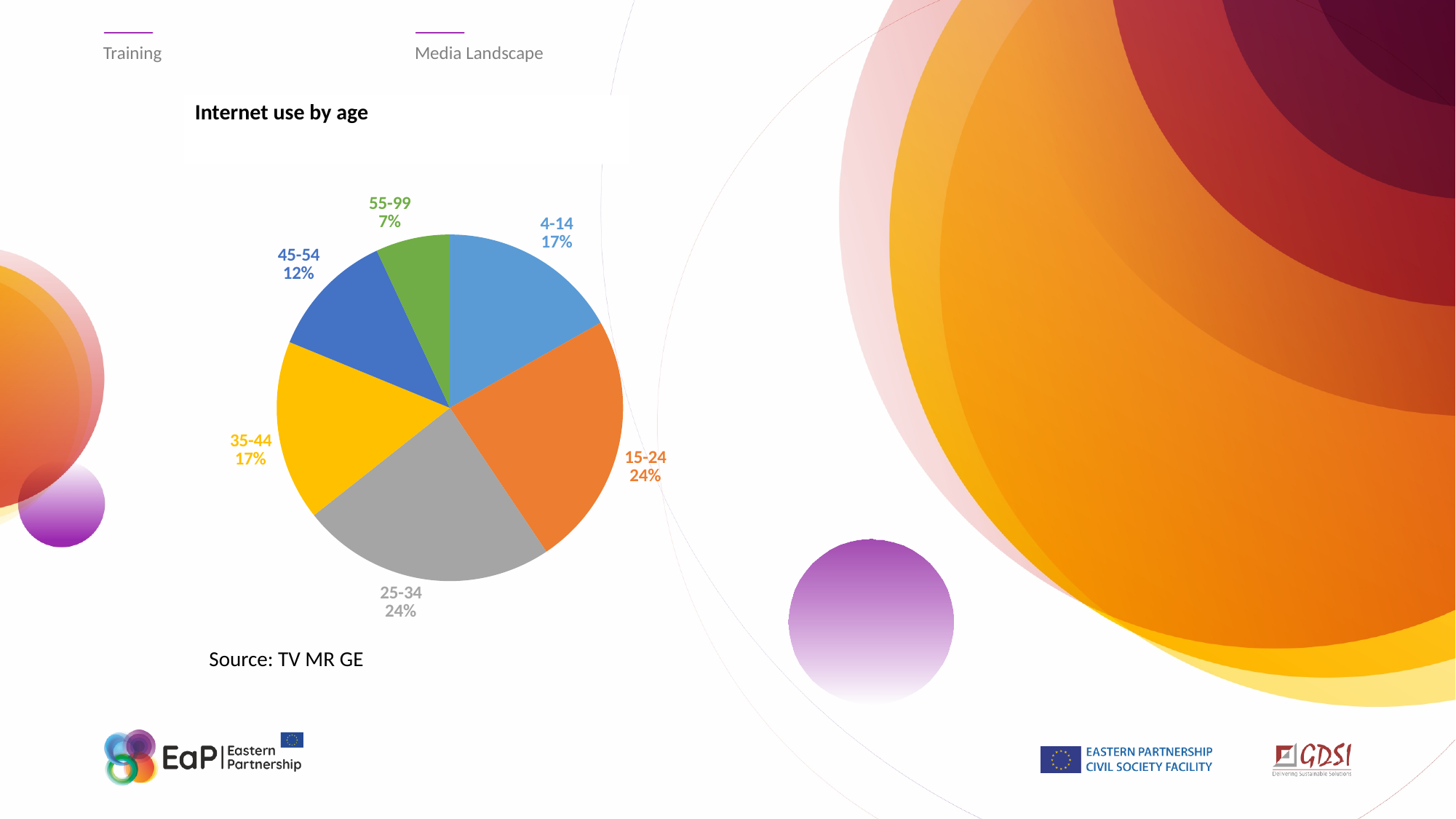
How many age groups are shown in the pie chart? 6 Which is larger, the share for 35-44 or the share for 55-99? 35-44 What source is cited for the chart? TV MR GE What percentage does the 15-24 age group account for? 24% What is the value shown for the 45-54 age group? 12% What percentage is shown for the 55-99 age group? 7% What is the difference between the shares of the 25-34 and 45-54 age groups? 12% What is the combined share of the 15-24 and 25-34 age groups? 48% What kind of chart is shown on the slide? Pie chart Which age group has the smallest share of the pie? 55-99 What is the title of the chart? Internet use by age What share of internet use is attributed to the 4-14 age group? 17%